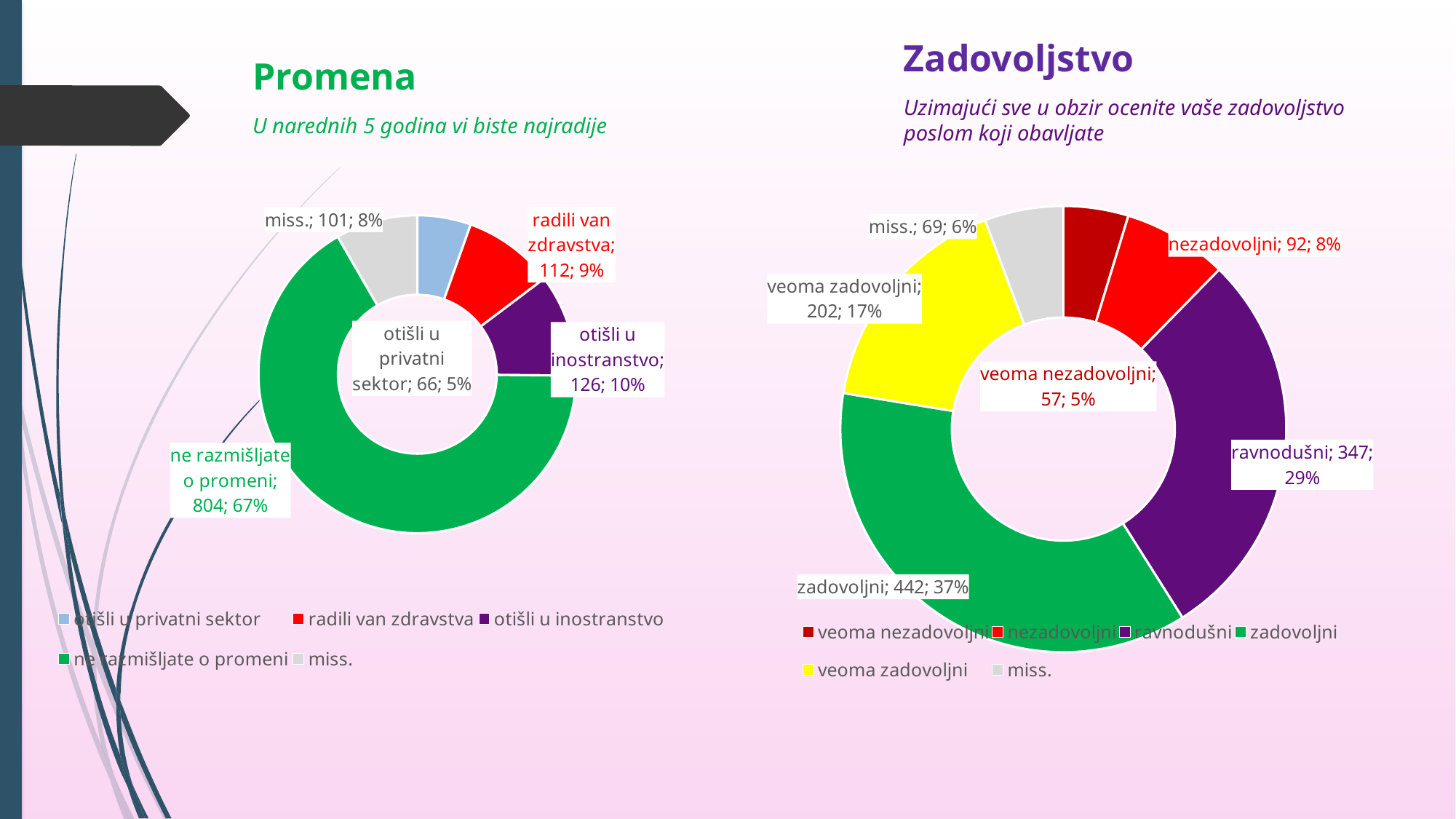
In the Promena chart, what percentage share does 'otišli u inostranstvo' have? 10% In the Zadovoljstvo chart, what percentage share does 'veoma nezadovoljni' have? 5% In the Promena chart, what is the difference between 'otišli u inostranstvo' and 'radili van zdravstva'? 14 In the Zadovoljstvo chart, which is larger: 'veoma zadovoljni' or 'nezadovoljni'? veoma zadovoljni In the Promena chart, how many categories are shown? 5 In the Zadovoljstvo chart, how many entries does the legend list? 6 What type of chart is the Zadovoljstvo chart? Doughnut chart In the Promena chart, which category has the smallest value? otišli u privatni sektor In the Zadovoljstvo chart, which category has the highest value? zadovoljni In the Zadovoljstvo chart, what is the difference between 'zadovoljni' and 'ravnodušni'? 95 In the Promena chart, how many respondents chose 'ne razmišljate o promeni'? 804 In the Zadovoljstvo chart, what is the value for 'ravnodušni'? 347